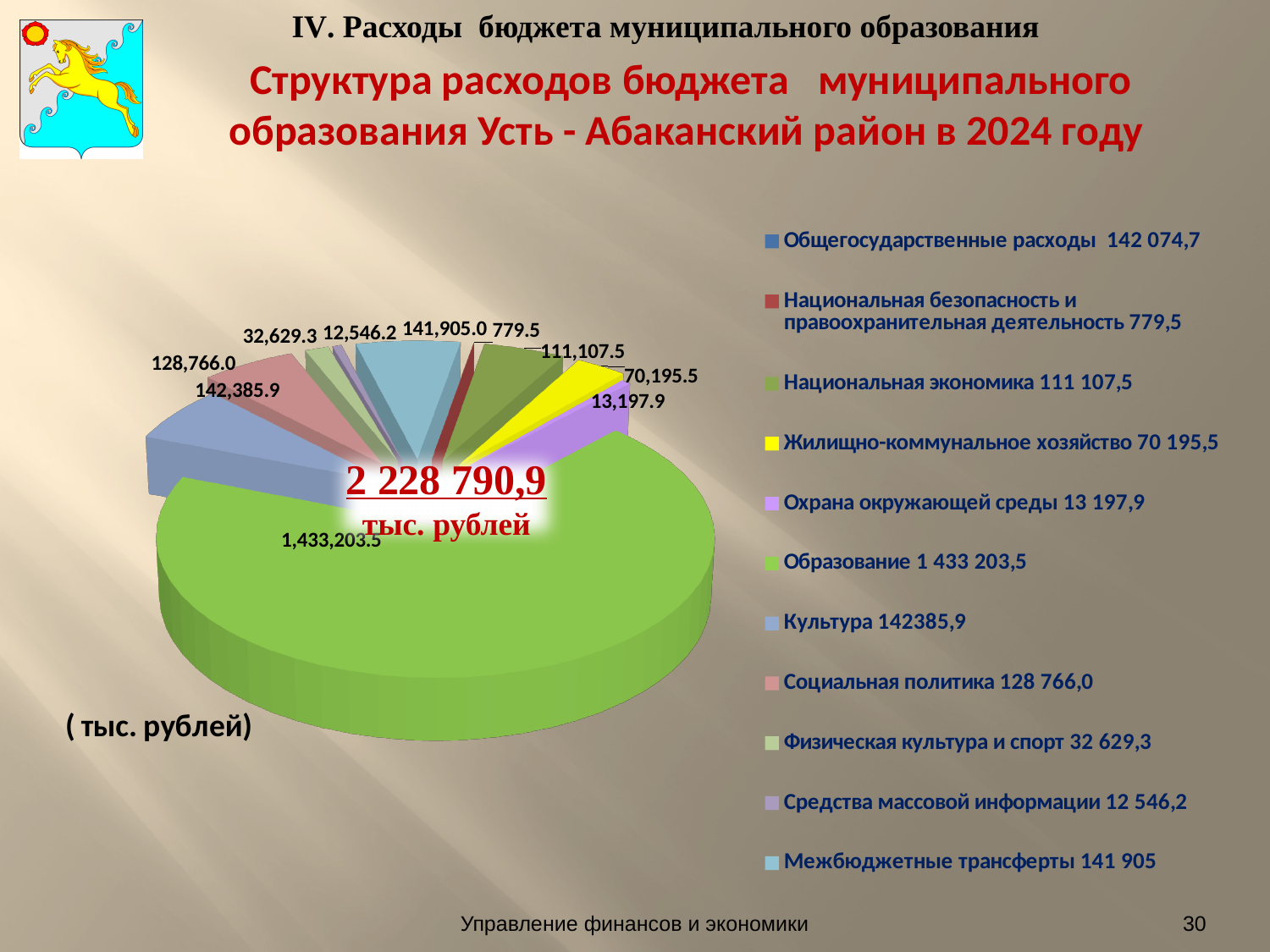
Which category has the largest slice of the pie chart? Образование Which is larger, Национальная экономика or Социальная политика? Социальная политика What kind of chart is shown on the slide? pie chart What total value is printed in the centre of the pie chart? 2 228 790,9 тыс. рублей What is the value for Охрана окружающей среды according to the legend? 13 197,9 What is the value for Жилищно-коммунальное хозяйство according to the legend? 70 195,5 How many expenditure categories does the legend of the pie chart list? 11 What is the difference between Национальная экономика (111 107,5) and Жилищно-коммунальное хозяйство (70 195,5)? 40 912,0 What is the value for Образование according to the legend? 1 433 203,5 Which category has the smallest value in the pie chart? Национальная безопасность и правоохранительная деятельность In what units are the values of the pie chart given, according to the label below the chart? тыс. рублей What is the value for Средства массовой информации according to the legend? 12 546,2